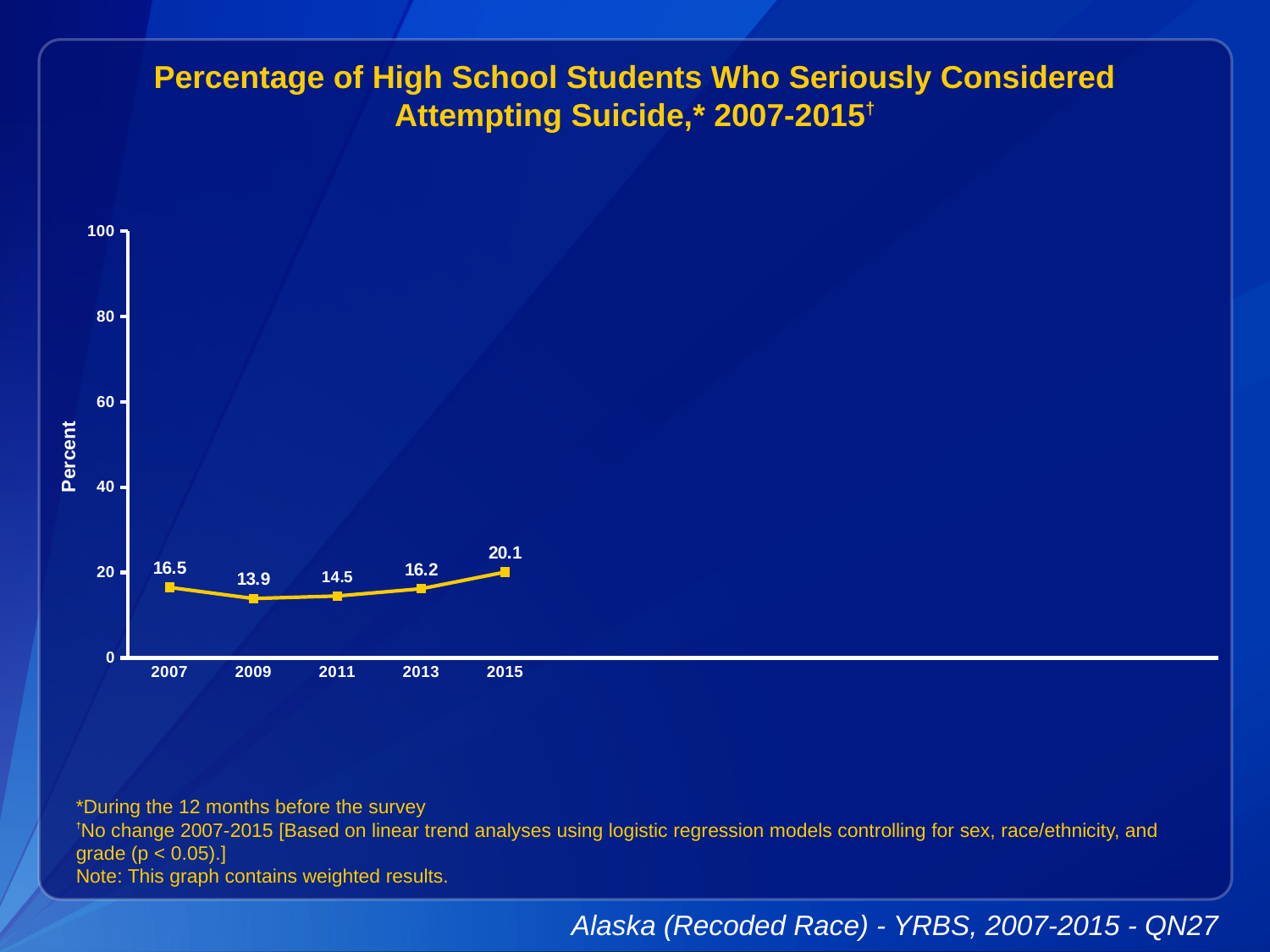
Which year has the lowest percentage? 2009 What is the label on the y axis? Percent What was the percentage of high school students who seriously considered attempting suicide in 2007? 16.5 What kind of chart is shown on the slide? line chart Does the value rise or fall from 2009 to 2015? rise Which year has the highest percentage? 2015 Is the value for 2015 greater or less than 40? less What is the difference between the 2015 value and the 2009 value? 6.2 Which is larger, the value for 2007 or the value for 2013? 2007 What was the percentage of high school students who seriously considered attempting suicide in 2015? 20.1 How many years are plotted on the chart? 5 What value is plotted for 2011? 14.5